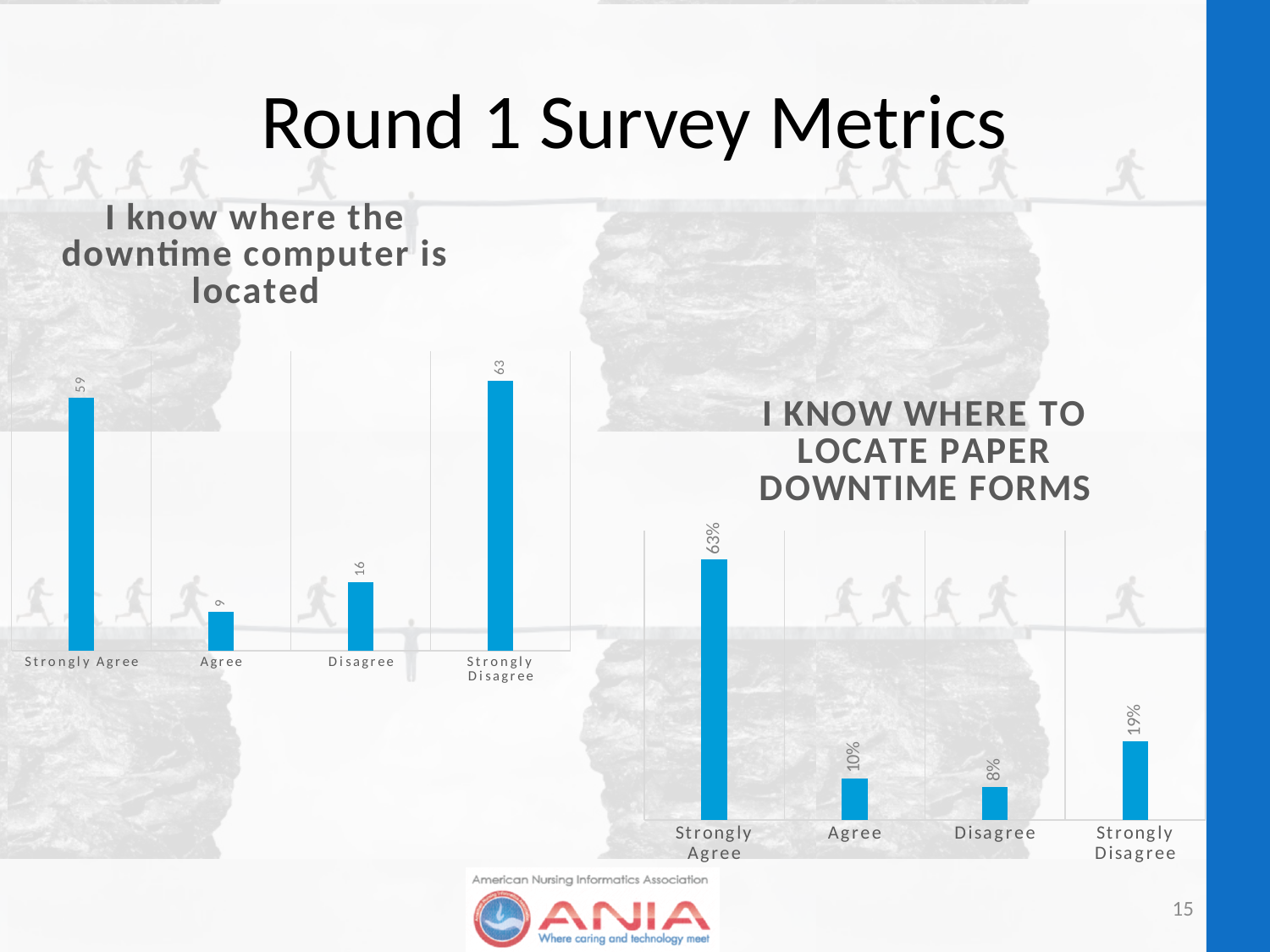
In the chart titled "I KNOW WHERE TO LOCATE PAPER DOWNTIME FORMS", which is larger, the value for Agree or the value for Disagree? Agree In the chart titled "I KNOW WHERE TO LOCATE PAPER DOWNTIME FORMS", what is the difference between the values for Strongly Agree and Strongly Disagree? 44% What kind of chart is the chart titled "I KNOW WHERE TO LOCATE PAPER DOWNTIME FORMS"? Bar chart In the chart titled "I know where the downtime computer is located", what is the value for Disagree? 16 In the chart titled "I KNOW WHERE TO LOCATE PAPER DOWNTIME FORMS", which category has the lowest value? Disagree How many categories are shown in the chart titled "I know where the downtime computer is located"? 4 In the chart titled "I know where the downtime computer is located", what is the difference between the values for Strongly Disagree and Strongly Agree? 4 In the chart titled "I know where the downtime computer is located", which category has the lowest value? Agree In the chart titled "I know where the downtime computer is located", what is the value for Strongly Agree? 59 In the chart titled "I KNOW WHERE TO LOCATE PAPER DOWNTIME FORMS", what is the value for Strongly Disagree? 19% In the chart titled "I KNOW WHERE TO LOCATE PAPER DOWNTIME FORMS", what is the value for Strongly Agree? 63% In the chart titled "I know where the downtime computer is located", which category has the highest value? Strongly Disagree